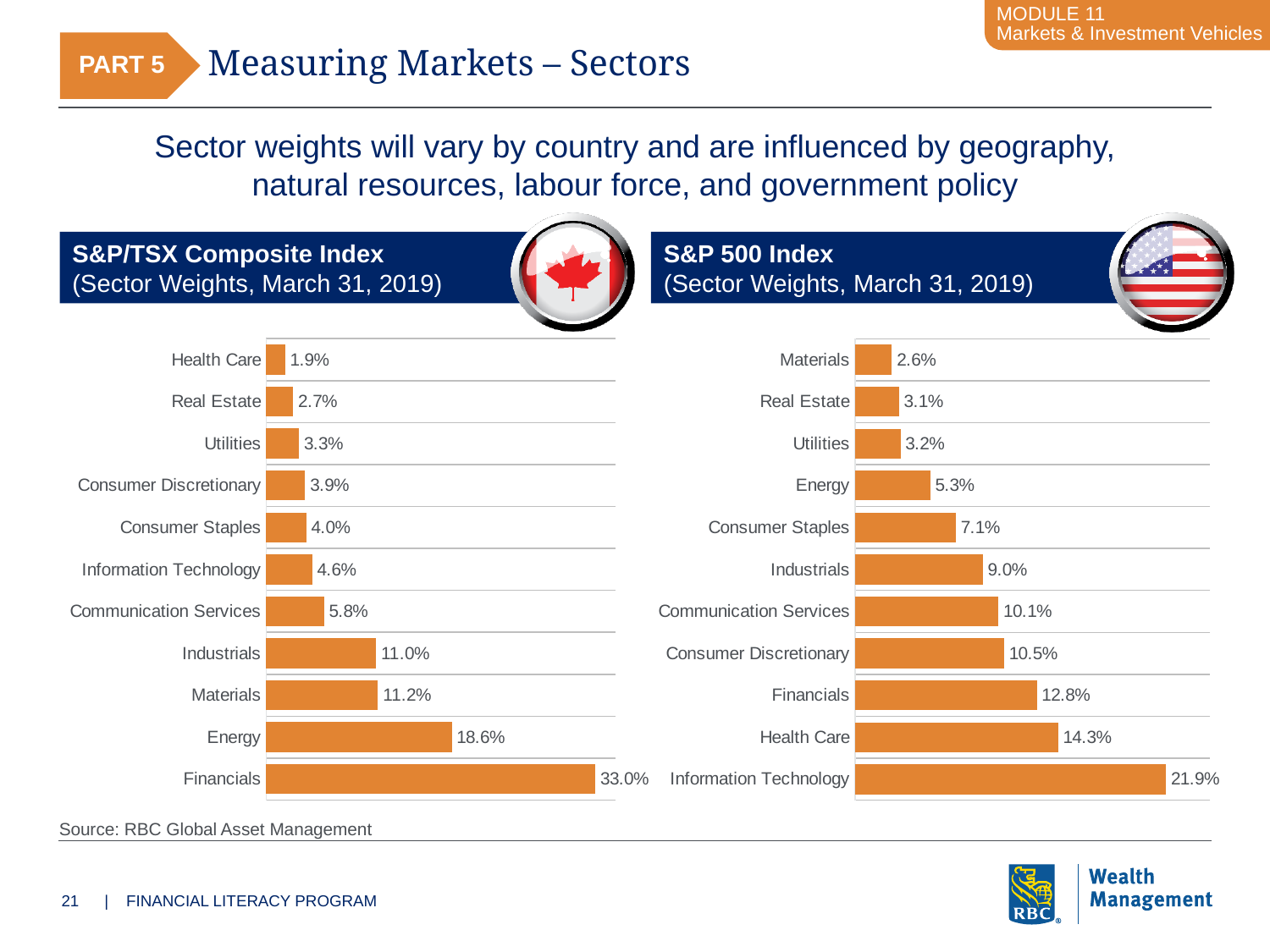
What type of chart is used for the S&P 500 Index sector weights? Bar chart In the S&P/TSX Composite Index chart, what is the sector weight for Energy? 18.6% In the S&P/TSX Composite Index chart, which sector has the highest weight? Financials In the S&P 500 Index chart, which is larger: the weight for Industrials or the weight for Consumer Staples? Industrials In the S&P 500 Index chart, what is the sector weight for Health Care? 14.3% How many sectors are shown in the S&P/TSX Composite Index chart? 11 In the S&P/TSX Composite Index chart, what is the sector weight for Information Technology? 4.6% In the S&P/TSX Composite Index chart, which is larger: the weight for Communication Services or the weight for Utilities? Communication Services In the S&P 500 Index chart, what is the difference between the Information Technology weight and the Financials weight? 9.1% In the S&P/TSX Composite Index chart, what is the difference between the Financials weight and the Energy weight? 14.4% In the S&P 500 Index chart, which sector has the lowest weight? Materials How many sectors are shown in the S&P 500 Index chart? 11